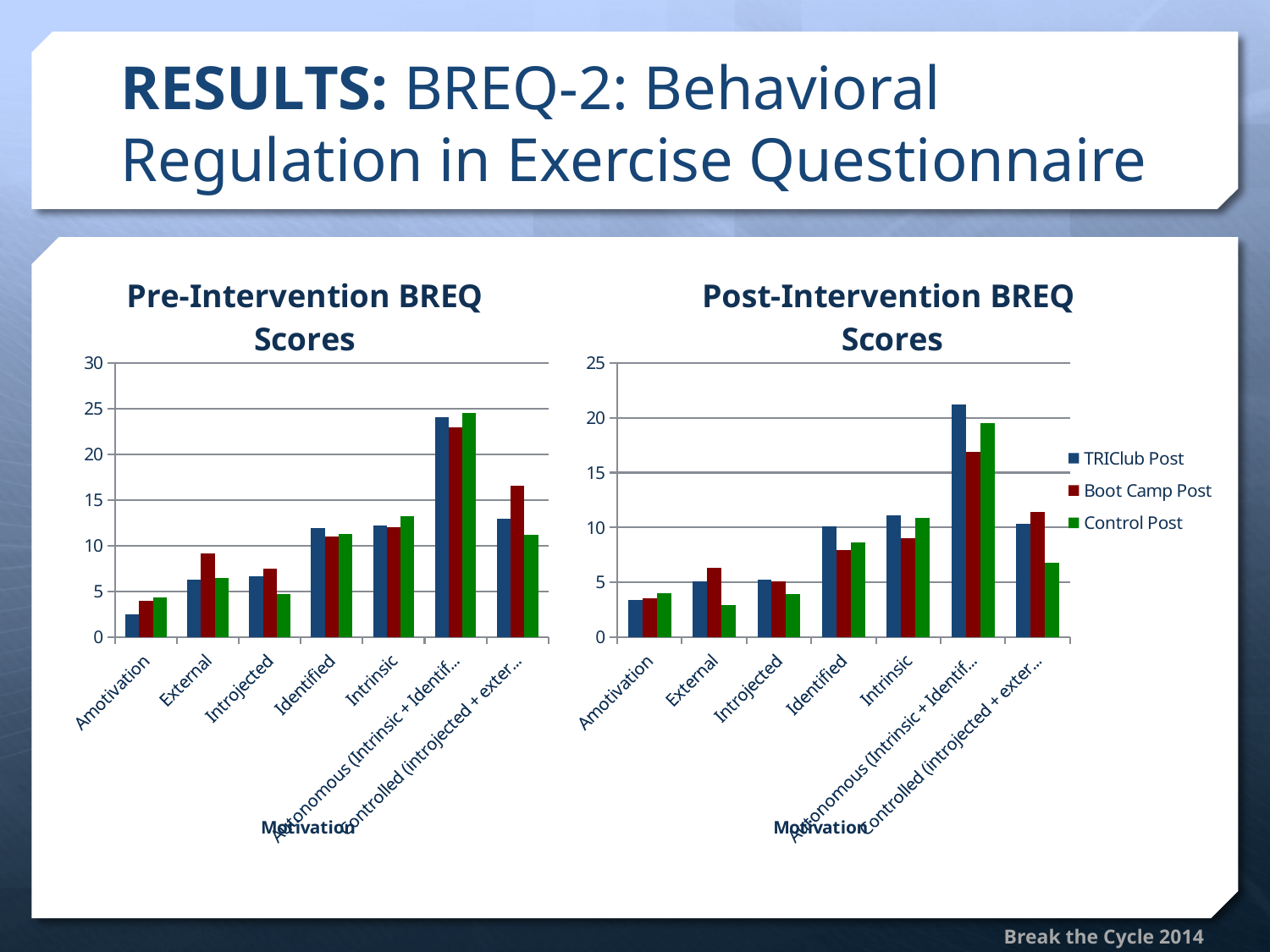
In the Pre-Intervention BREQ Scores chart, are the Amotivation bars greater or less than 5? less In the Pre-Intervention BREQ Scores chart, which category has the highest bars? Autonomous (Intrinsic + Identif... How many categories are shown on the x axis of the Post-Intervention BREQ Scores chart? 7 What kind of chart is the Pre-Intervention BREQ Scores chart? Bar chart Which series in the Post-Intervention BREQ Scores chart is shown in green? Control Post In the Post-Intervention BREQ Scores chart, is the TRIClub Post value for Autonomous (Intrinsic + Identif... greater or less than 20? greater How many series does the legend of the Post-Intervention BREQ Scores chart list? 3 What is the x-axis title of the Post-Intervention BREQ Scores chart? Motivation In the Post-Intervention BREQ Scores chart, which category has the lowest bars? Amotivation In the Post-Intervention BREQ Scores chart, is the Control Post value for Controlled (introjected + exter... greater or less than 10? less In the Post-Intervention BREQ Scores chart, which is larger for External: Boot Camp Post or Control Post? Boot Camp Post In the Post-Intervention BREQ Scores chart, which is larger for Autonomous (Intrinsic + Identif...: TRIClub Post or Boot Camp Post? TRIClub Post